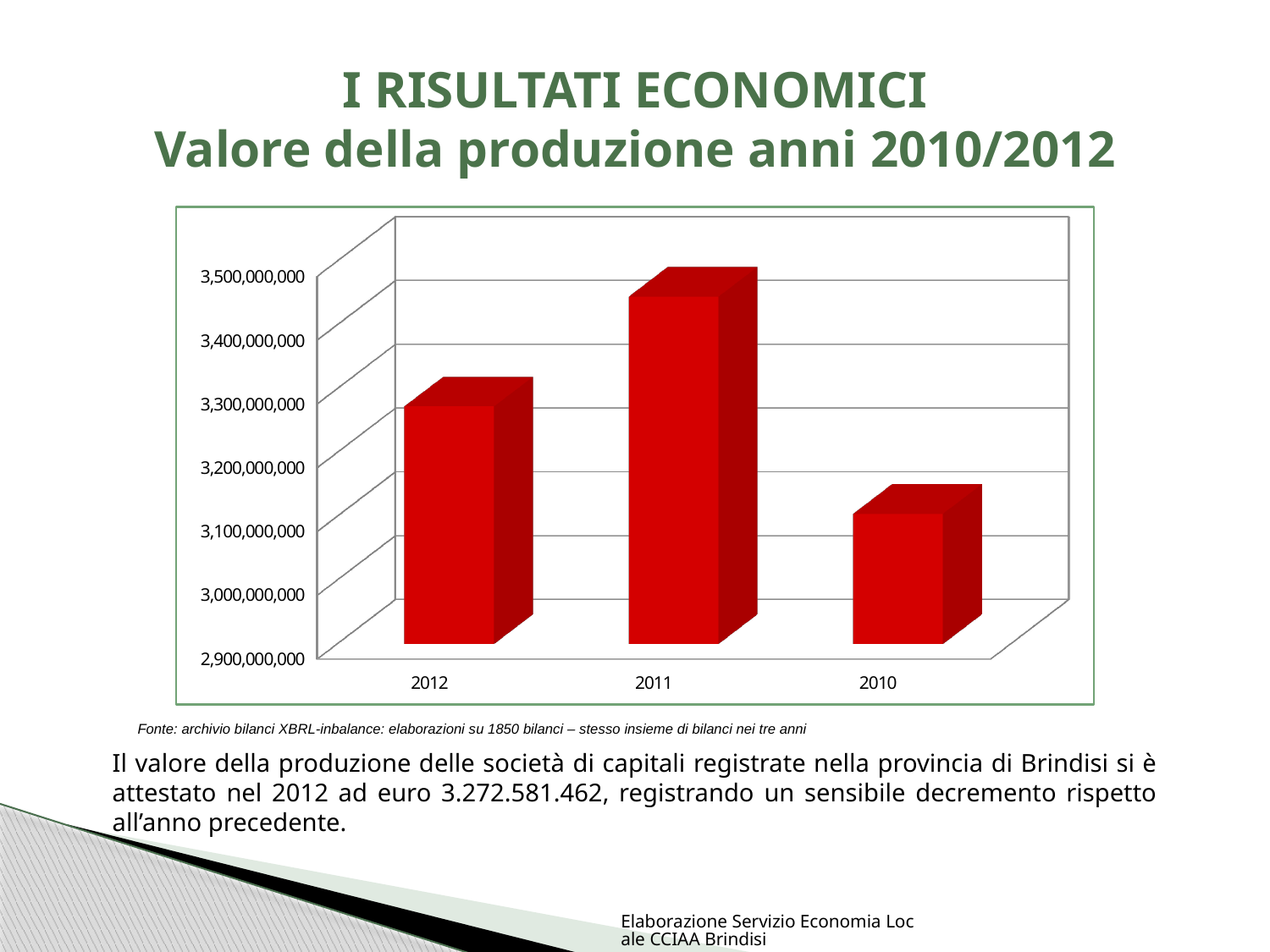
Which year has the larger value, 2012 or 2010? 2012 Is the value for 2011 greater or less than 3,400,000,000? greater How many years are shown on the x axis of the chart? 3 What is the title of the slide containing the chart? I RISULTATI ECONOMICI Valore della produzione anni 2010/2012 What is the lowest value shown on the y axis of the chart? 2,900,000,000 Which year has the larger value, 2011 or 2012? 2011 What kind of chart is shown on the slide? bar chart Is the value for 2012 greater or less than 3,200,000,000? greater Is the value for 2010 greater or less than 3,000,000,000? greater Which year has the lowest value in the chart? 2010 Which year has the highest value in the chart? 2011